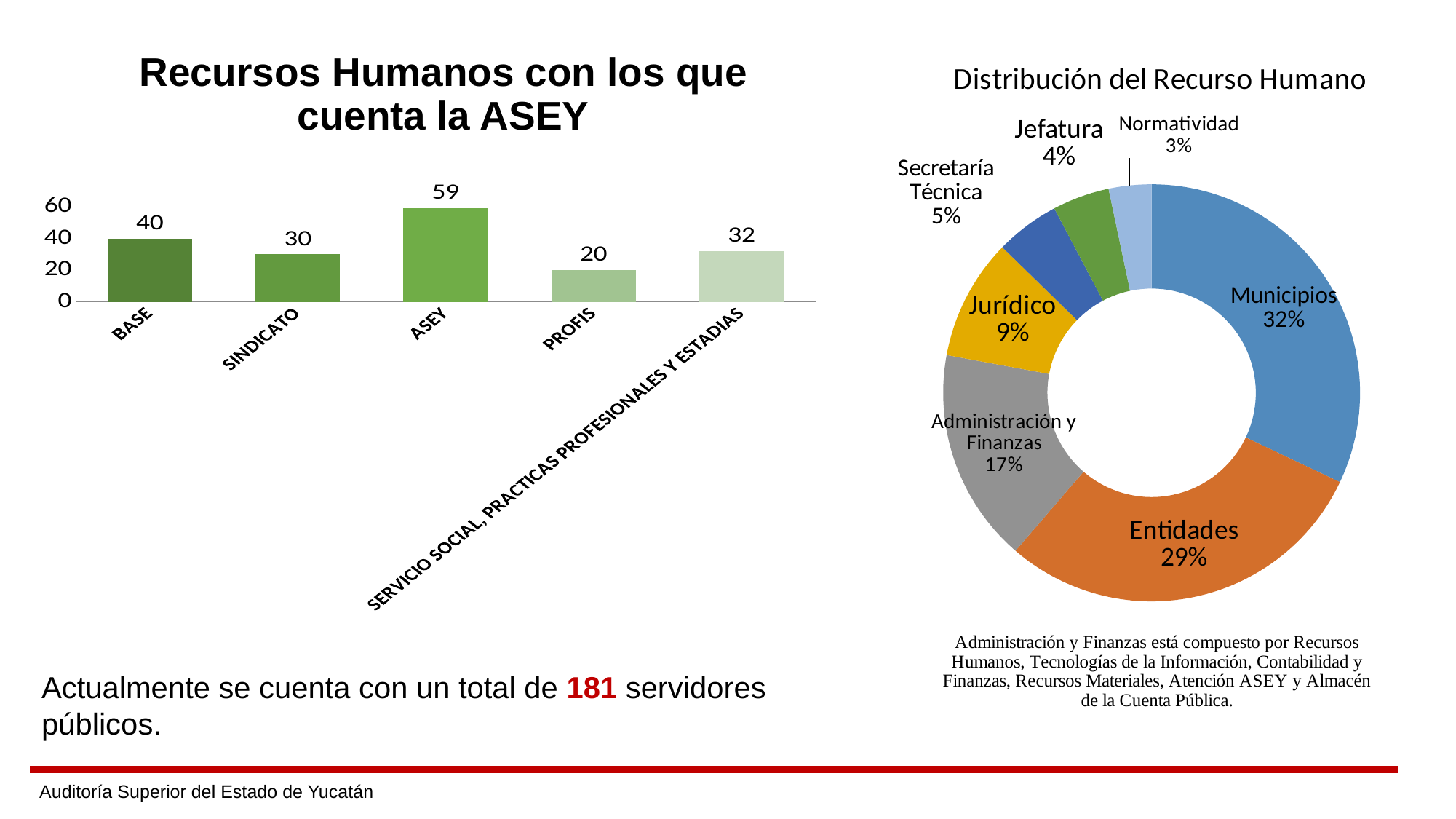
In the bar chart 'Recursos Humanos con los que cuenta la ASEY', which is larger: the value for BASE or the value for SERVICIO SOCIAL, PRACTICAS PROFESIONALES Y ESTADIAS? BASE In the bar chart 'Recursos Humanos con los que cuenta la ASEY', what is the difference between the values for BASE and PROFIS? 20 In the bar chart 'Recursos Humanos con los que cuenta la ASEY', which category has the highest value? ASEY In the bar chart 'Recursos Humanos con los que cuenta la ASEY', which category has the lowest value? PROFIS In the chart 'Distribución del Recurso Humano', what share does Municipios have? 32% In the chart 'Distribución del Recurso Humano', which segment is the smallest? Normatividad In the chart 'Distribución del Recurso Humano', what share does Administración y Finanzas have? 17% How many categories are shown in the bar chart 'Recursos Humanos con los que cuenta la ASEY'? 5 How many segments are shown in the chart 'Distribución del Recurso Humano'? 7 In the bar chart 'Recursos Humanos con los que cuenta la ASEY', what is the value for ASEY? 59 What kind of chart is 'Recursos Humanos con los que cuenta la ASEY'? Bar chart In the bar chart 'Recursos Humanos con los que cuenta la ASEY', what is the value for SINDICATO? 30